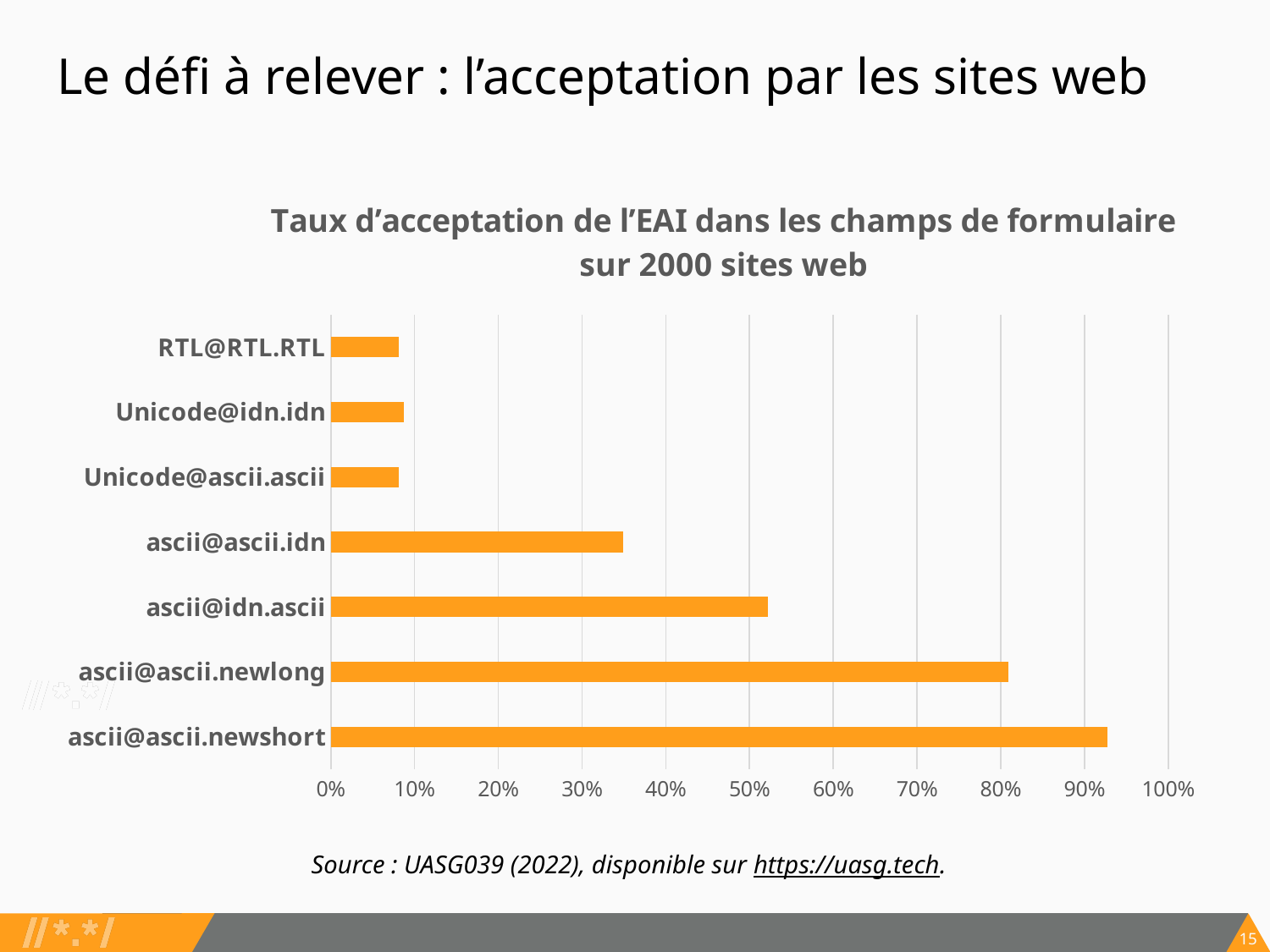
Is the value for RTL@RTL.RTL greater or less than 10%? less Which is larger, the value for ascii@ascii.idn or the value for Unicode@ascii.ascii? ascii@ascii.idn Which is larger, the value for ascii@ascii.newlong or the value for ascii@idn.ascii? ascii@ascii.newlong Is the value for ascii@ascii.idn greater or less than 40%? less How many categories are plotted in the chart? 7 Is the value for ascii@ascii.newshort greater or less than 90%? greater What is the title of the chart? Taux d’acceptation de l’EAI dans les champs de formulaire sur 2000 sites web Which category has the highest acceptance rate? ascii@ascii.newshort What kind of chart is shown on the slide? bar chart